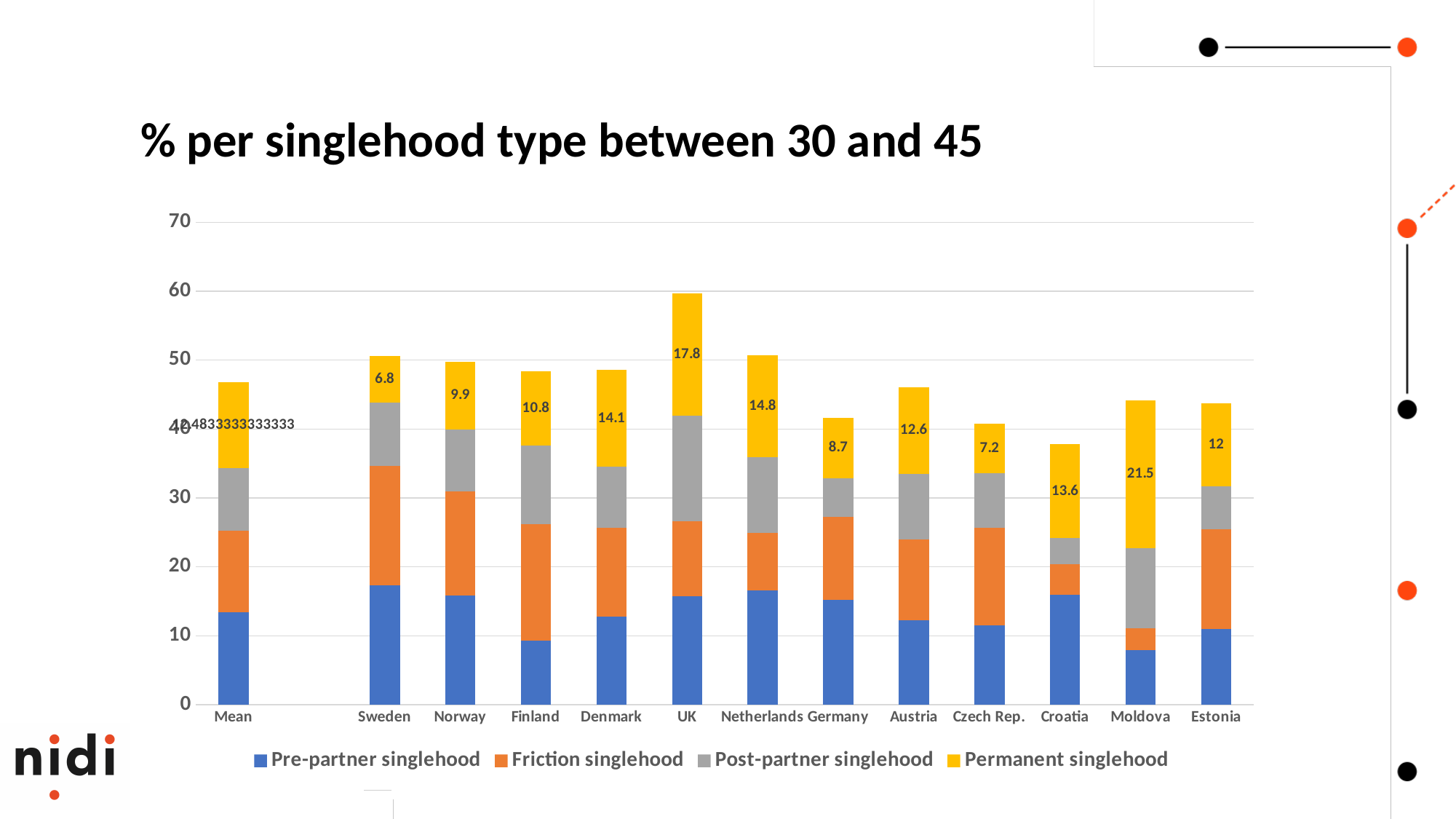
Is the total stacked value for the UK greater or less than 50? greater Which country has the lowest Permanent singlehood value? Sweden What is the Permanent singlehood value for the UK? 17.8 What is the Permanent singlehood value for Moldova? 21.5 How many series does the legend list? 4 How many categories are shown on the x axis? 13 Which series is shown in yellow in the legend? Permanent singlehood Which has a larger Permanent singlehood value, Denmark or Austria? Denmark What is the difference between the Permanent singlehood values for Moldova and Sweden? 14.7 What type of chart is shown on the slide? Stacked bar chart Which country has the highest Permanent singlehood value? Moldova What is the Permanent singlehood value for Sweden? 6.8